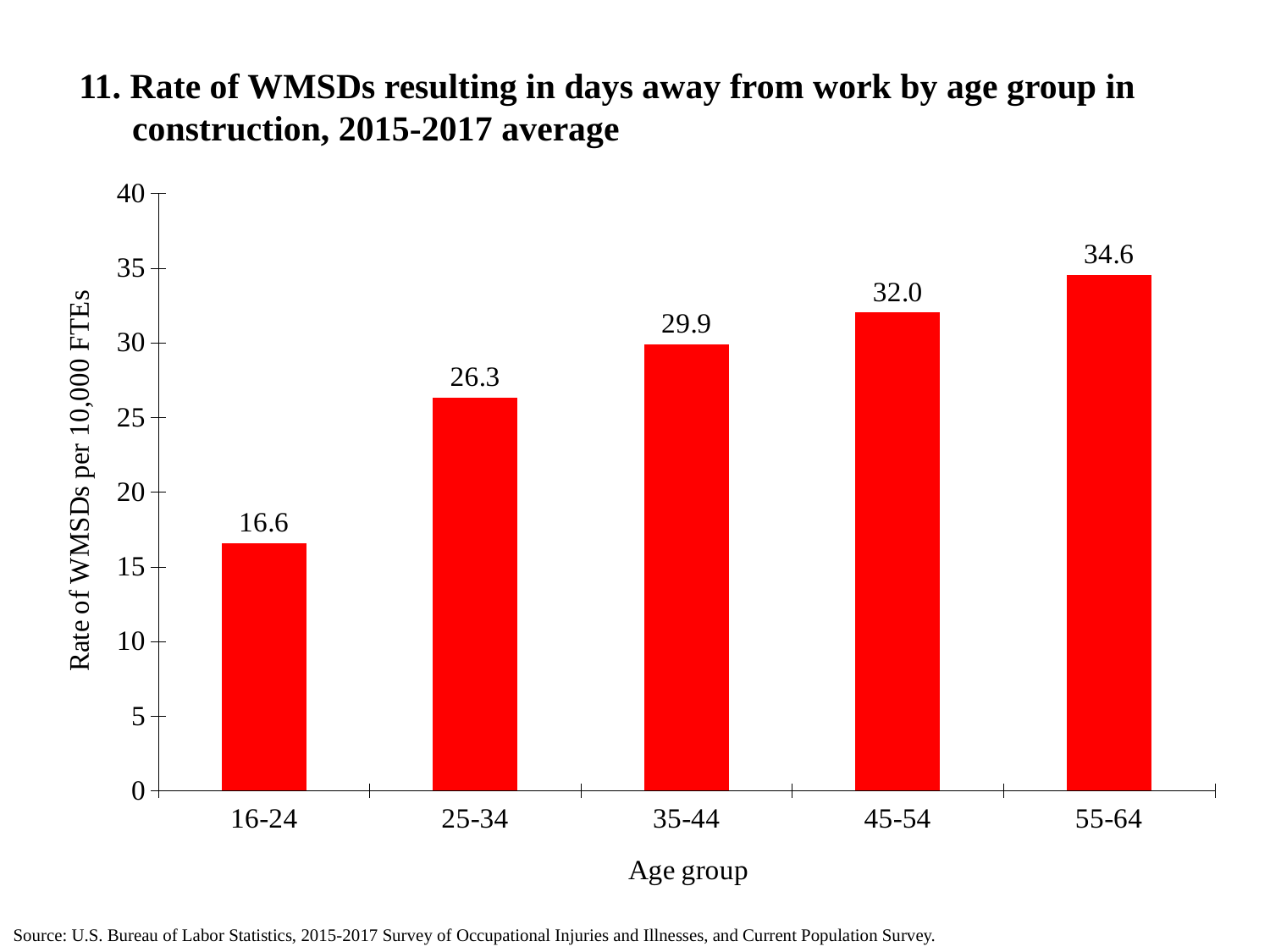
What is the difference in WMSD rate between the 55-64 and 16-24 age groups? 18.0 What kind of chart is shown on the slide? Bar chart What is the rate of WMSDs per 10,000 FTEs for the 35-44 age group? 29.9 What is the difference in WMSD rate between the 45-54 and 25-34 age groups? 5.7 How many age groups are shown in the chart? 5 Which age group has the lowest rate of WMSDs? 16-24 What is the rate of WMSDs per 10,000 FTEs for the 55-64 age group? 34.6 Is the WMSD rate for the 35-44 age group greater or less than 25? greater Which age group has the highest rate of WMSDs? 55-64 What is the rate of WMSDs per 10,000 FTEs for the 16-24 age group? 16.6 Do the WMSD rates rise or fall as age group increases along the x axis? Rise Which age group has a higher WMSD rate, 25-34 or 45-54? 45-54